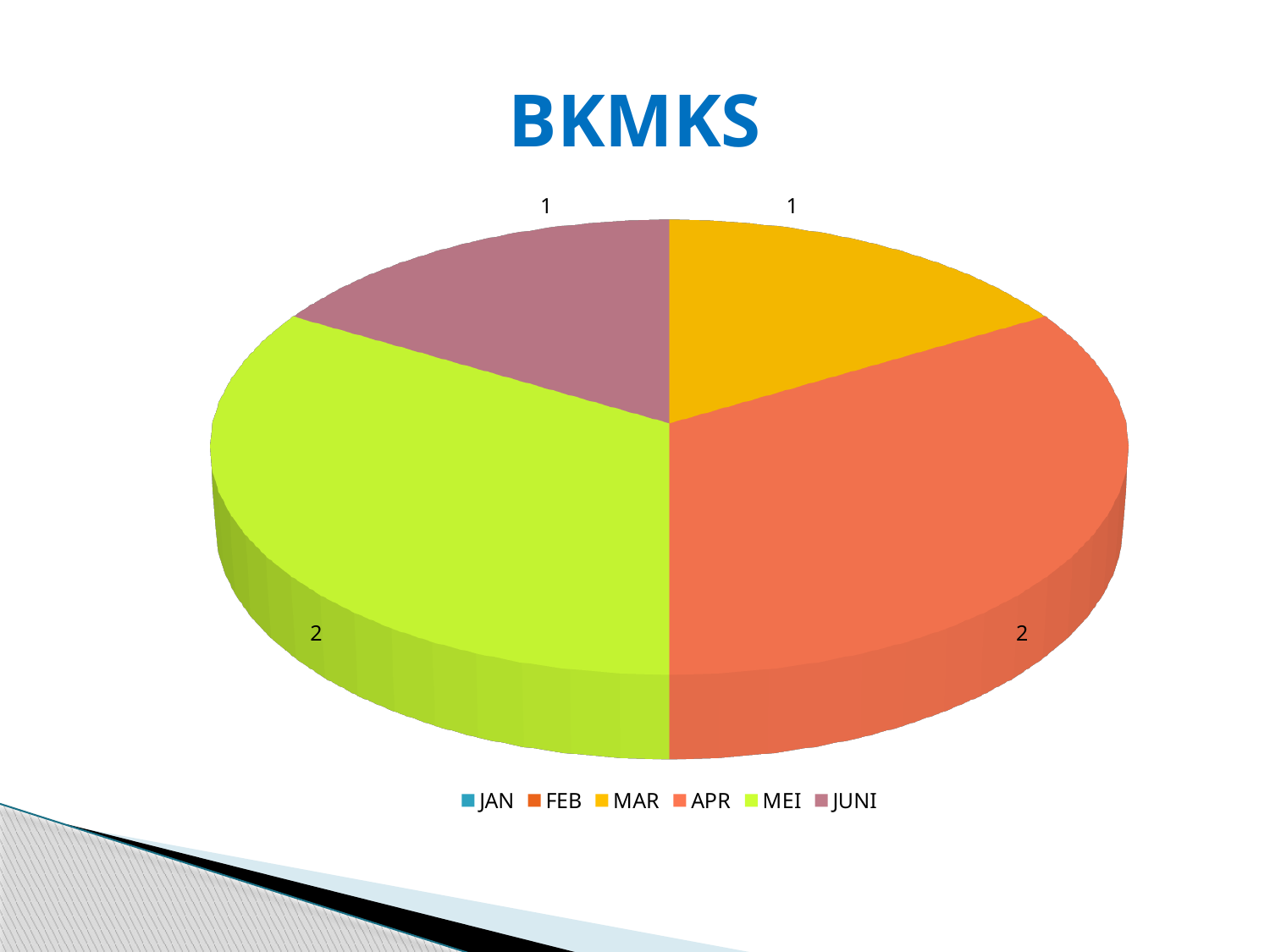
What is the value of the JUNI slice? 1 Which is larger, the MEI slice or the JUNI slice? MEI How many entries does the chart's legend list? 6 What is the value of the APR slice? 2 What is the title of the chart? BKMKS What is the value of the MAR slice? 1 What colour is the MEI slice? green What kind of chart is shown on the slide? pie chart What is the value of the MEI slice? 2 What is the difference between the APR value and the JUNI value? 1 Which is larger, the APR slice or the MAR slice? APR How many slices are visible in the pie chart? 4